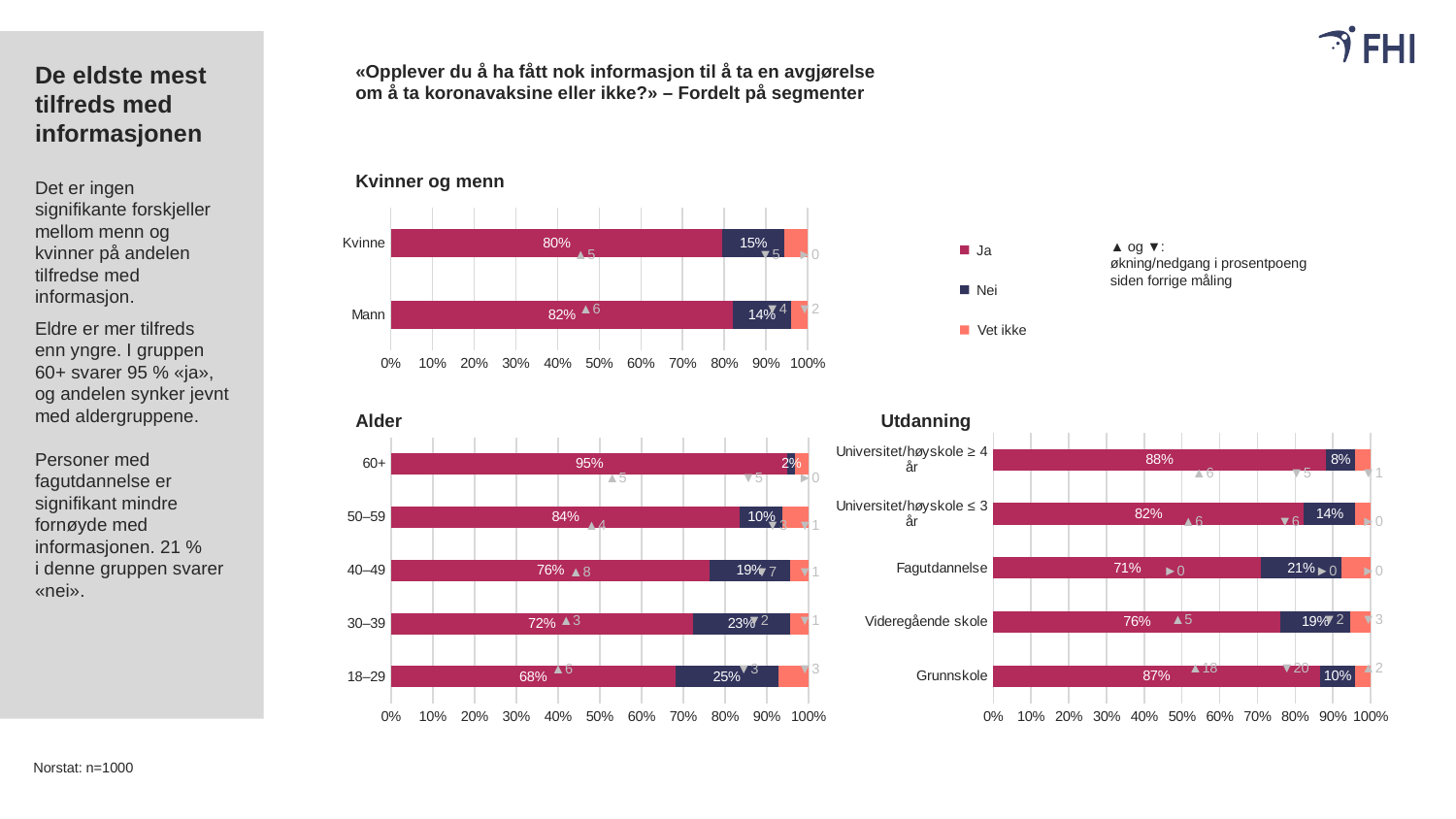
In the 'Kvinner og menn' chart, what is the 'Nei' value for Mann? 14% In the 'Alder' chart, what is the difference in 'Ja' values between the 60+ group and the 18–29 group? 27 percentage points In the 'Alder' chart, does the 'Ja' value rise or fall as you move from the 60+ group down to the 18–29 group? fall In the 'Utdanning' chart, which is larger: the 'Ja' value for Grunnskole or for Videregående skole? Grunnskole How many categories are shown in the 'Utdanning' chart? 5 In the 'Kvinner og menn' chart, what is the 'Ja' value for Kvinne? 80% In the 'Alder' chart, which age group has the highest 'Ja' value? 60+ In the 'Utdanning' chart, which education group has the highest 'Nei' value? Fagutdannelse In the 'Alder' chart, what is the 'Nei' value for the 30–39 group? 23% How many series does the legend list for the charts? 3 In the 'Alder' chart, which age group has the lowest 'Ja' value? 18–29 In the 'Utdanning' chart, what is the 'Ja' value for Fagutdannelse? 71%